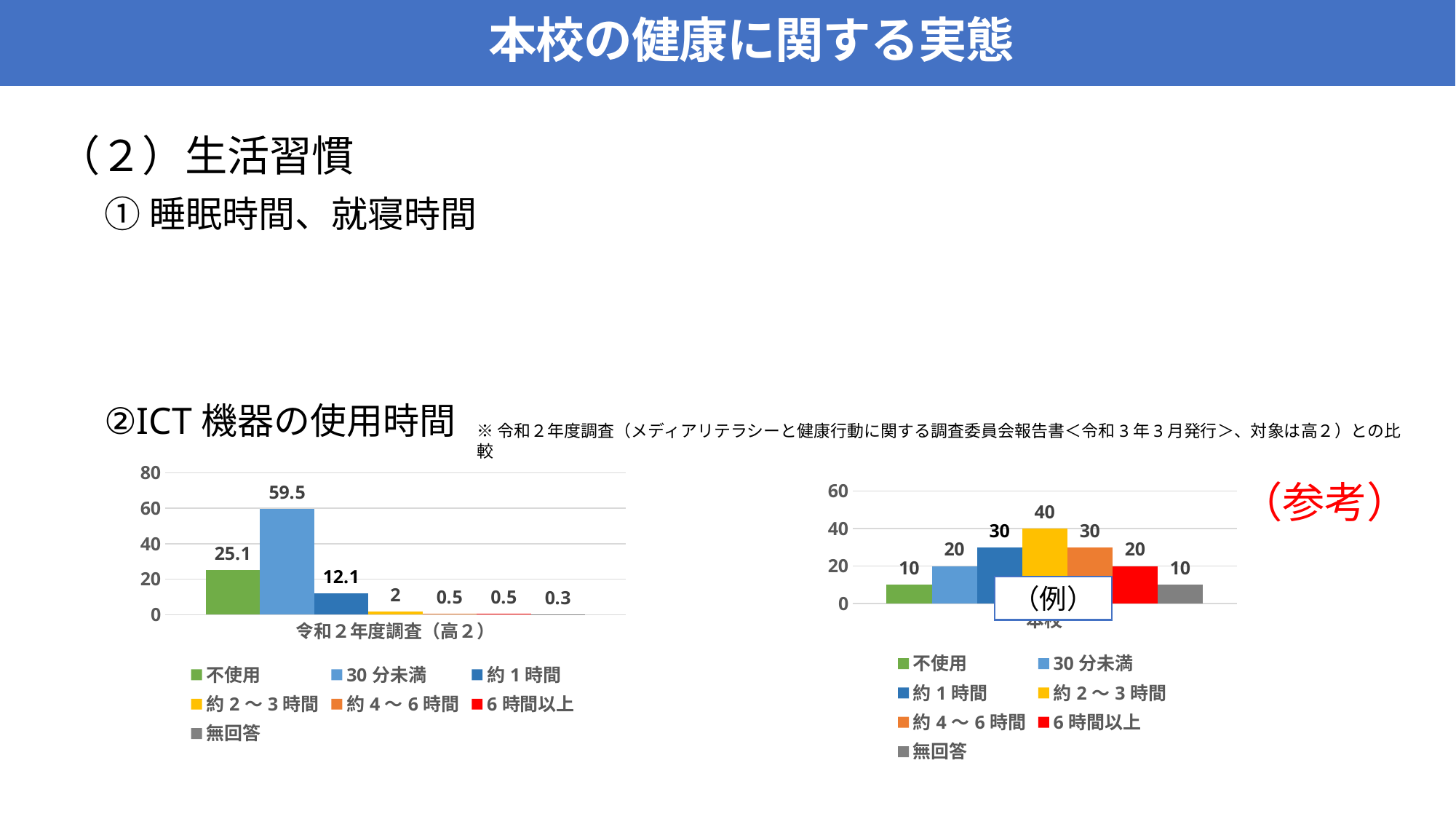
In the right chart (参考), what is the difference between the values for 約２～３時間 and 不使用? 30 In the right chart (参考), is the value for 約１時間 larger or smaller than the value for 6時間以上? larger In the right chart (参考), which series has the highest value? 約２～３時間 In the left chart (令和２年度調査（高２）), what is the value for 約１時間? 12.1 In the left chart (令和２年度調査（高２）), what is the value for 30分未満? 59.5 In the left chart (令和２年度調査（高２）), which series has the lowest value? 無回答 In the right chart (参考), what is the value for 約２～３時間? 40 In the left chart (令和２年度調査（高２）), what is the difference between the values for 30分未満 and 不使用? 34.4 In the left chart (令和２年度調査（高２）), which series has the highest value? 30分未満 What kind of chart is the left chart (令和２年度調査（高２）)? bar chart In the left chart (令和２年度調査（高２）), what is the value for 不使用? 25.1 In the left chart (令和２年度調査（高２）), how many series does the legend list? 7